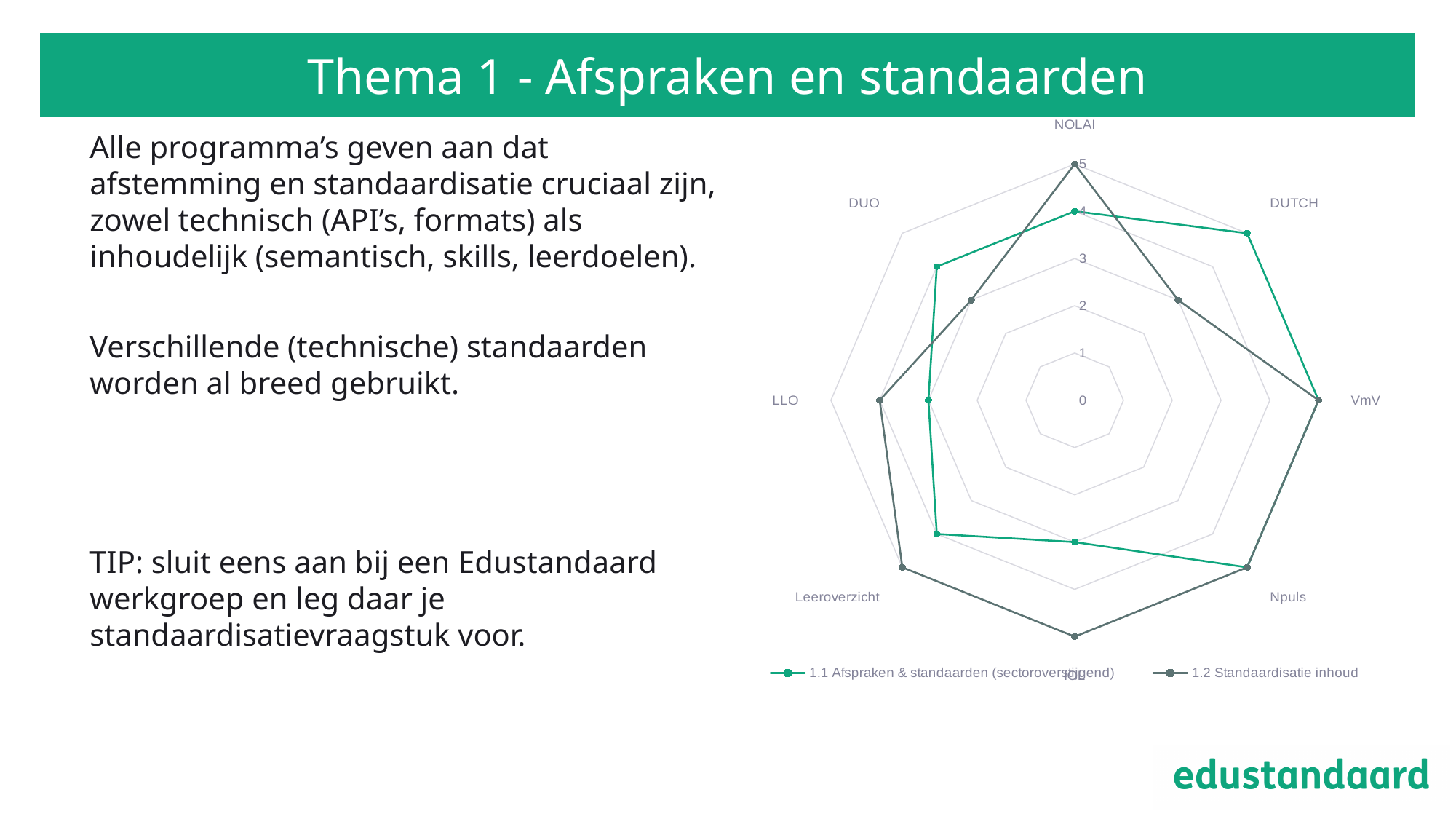
What is the value for Leeroverzicht in the series '1.2 Standaardisatie inhoud'? 5 What is the highest value on the chart's axis scale? 5 Which category has the lowest value in the series '1.2 Standaardisatie inhoud'? DUTCH and DUO (both 3) What is the difference between the two series' values for DUO? 1 What is the value for NOLAI in the series '1.2 Standaardisatie inhoud'? 5 What is the value for DUTCH in the series '1.2 Standaardisatie inhoud'? 3 How many categories (axes) does the radar chart have? 8 What is the value for LLO in the series '1.1 Afspraken & standaarden (sectoroverstijgend)'? 3 What is the value for NOLAI in the series '1.1 Afspraken & standaarden (sectoroverstijgend)'? 4 How many series does the chart legend list? 2 What kind of chart is shown on the slide? Radar chart For DUTCH, which series has the larger value: '1.1 Afspraken & standaarden (sectoroverstijgend)' or '1.2 Standaardisatie inhoud'? 1.1 Afspraken & standaarden (sectoroverstijgend)